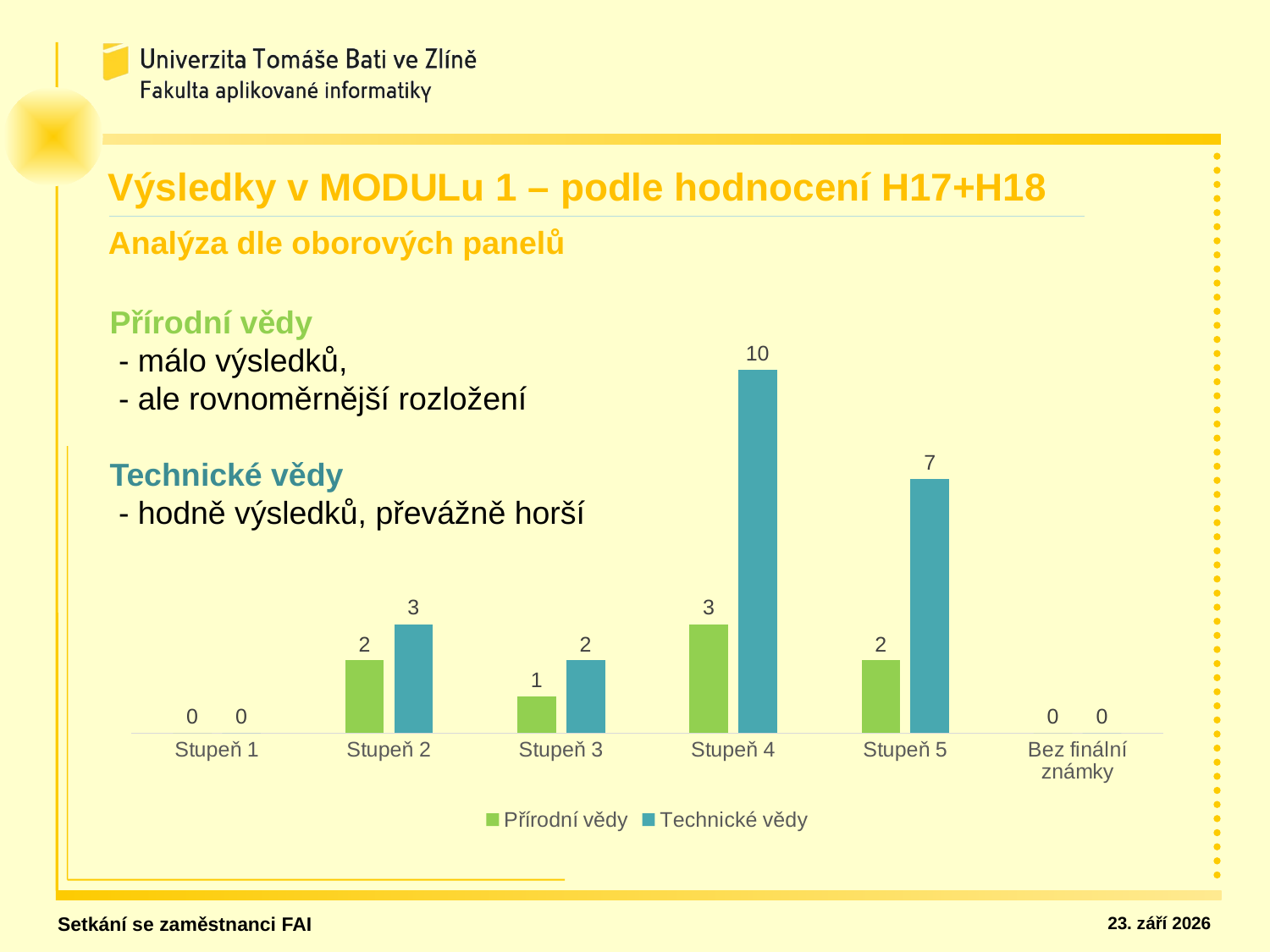
What kind of chart is shown on the slide? bar chart What is the value for Přírodní vědy at Stupeň 3? 1 How many categories are shown on the x axis? 6 What is the difference between Technické vědy and Přírodní vědy at Stupeň 4? 7 What is the value for Technické vědy at Stupeň 4? 10 What is the value for Technické vědy at Stupeň 5? 7 Which is larger at Stupeň 5: Přírodní vědy or Technické vědy? Technické vědy What is the total of Přírodní vědy and Technické vědy at Stupeň 2? 5 Which category has the highest value for Přírodní vědy? Stupeň 4 How many series does the legend list? 2 Which category has the highest value for Technické vědy? Stupeň 4 What is the value for Přírodní vědy at Stupeň 2? 2